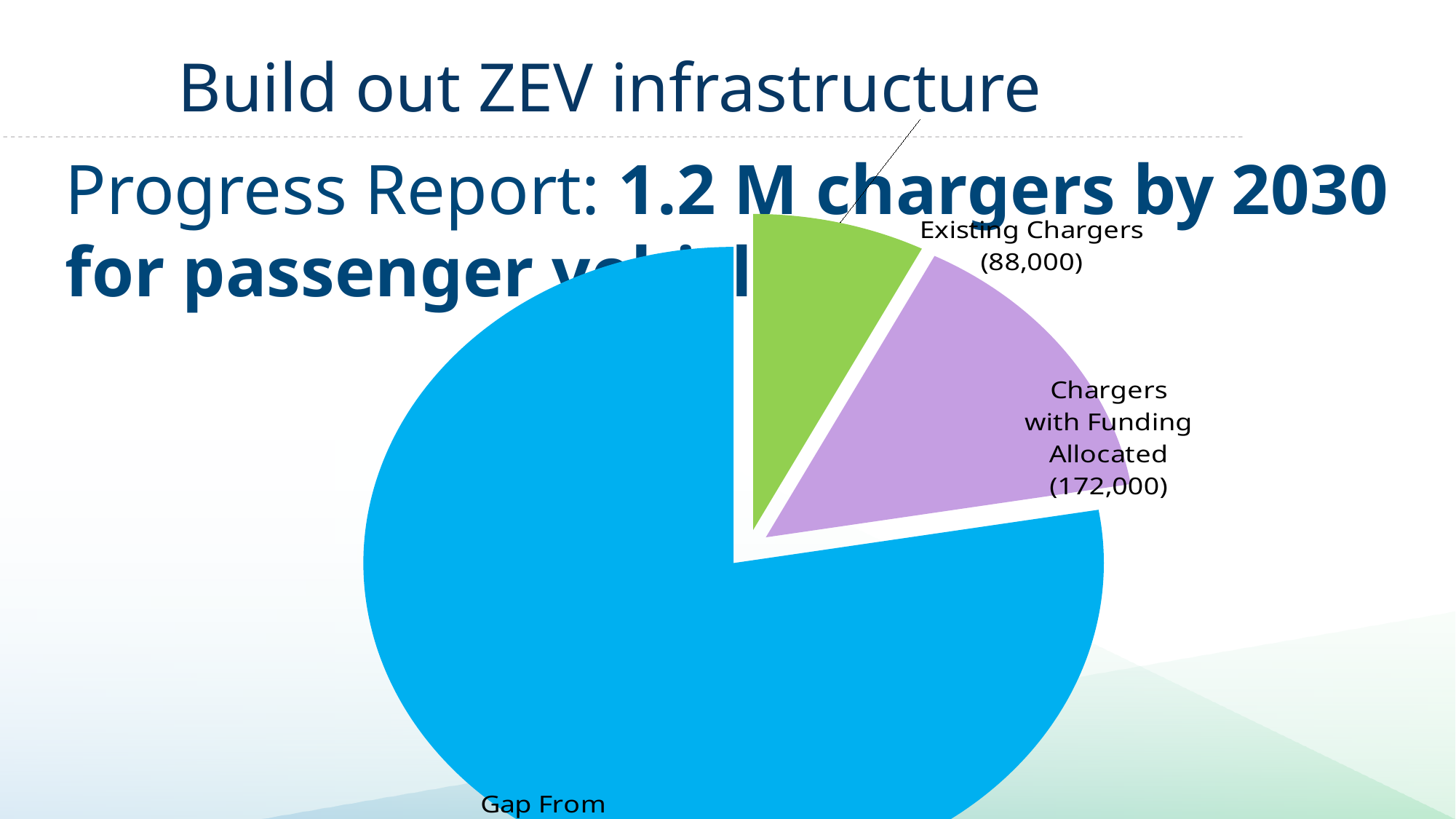
Is the value for Chargers with Funding Allocated greater or less than 100,000? greater What is the difference between Chargers with Funding Allocated and Existing Chargers? 84,000 What colour is the Existing Chargers slice? green Which is larger, Existing Chargers or Chargers with Funding Allocated? Chargers with Funding Allocated Which slice of the pie chart is the smallest? Existing Chargers How many slices does the pie chart have? 3 Is the value for Existing Chargers greater or less than 100,000? less What colour is the Chargers with Funding Allocated slice? purple What value is shown for Existing Chargers? 88,000 What value is shown for Chargers with Funding Allocated? 172,000 What kind of chart is shown on the slide? pie chart